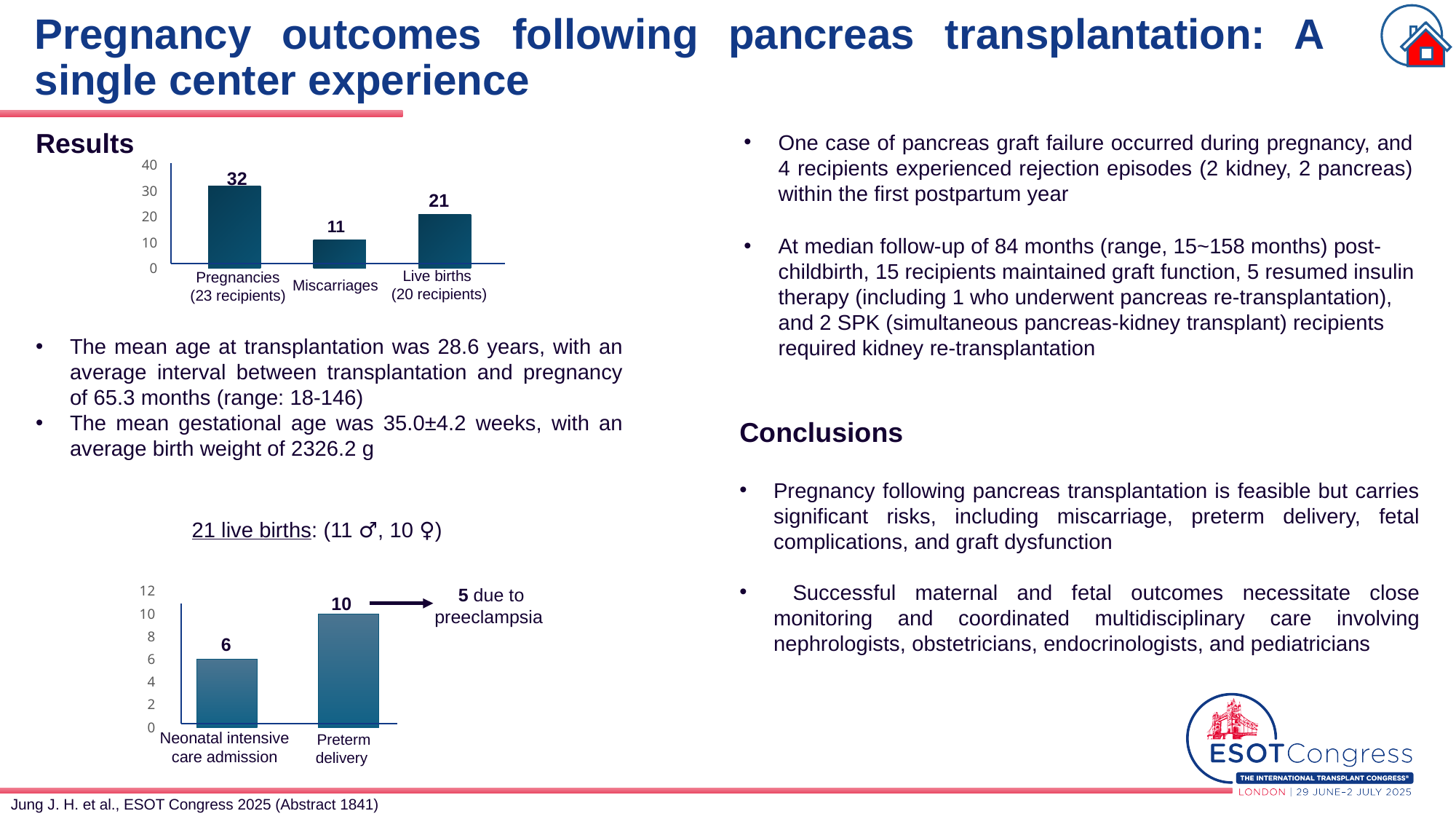
What kind of chart is the upper chart? Bar chart In the upper chart, which category has the lowest value? Miscarriages In the lower chart, what is the difference between Preterm delivery and Neonatal intensive care admission? 4 In the lower chart (Neonatal intensive care admission, Preterm delivery), what is the value for Preterm delivery? 10 In the upper chart, how many categories are shown? 3 In the upper chart, what is the difference between Pregnancies and Live births? 11 In the upper chart (Pregnancies, Miscarriages, Live births), what is the value for Pregnancies? 32 In the lower chart, what is the value for Neonatal intensive care admission? 6 In the upper chart, which category has the highest value? Pregnancies In the upper chart, what is the value for Miscarriages? 11 In the lower chart, which is larger: Neonatal intensive care admission or Preterm delivery? Preterm delivery In the upper chart, what is the value for Live births? 21